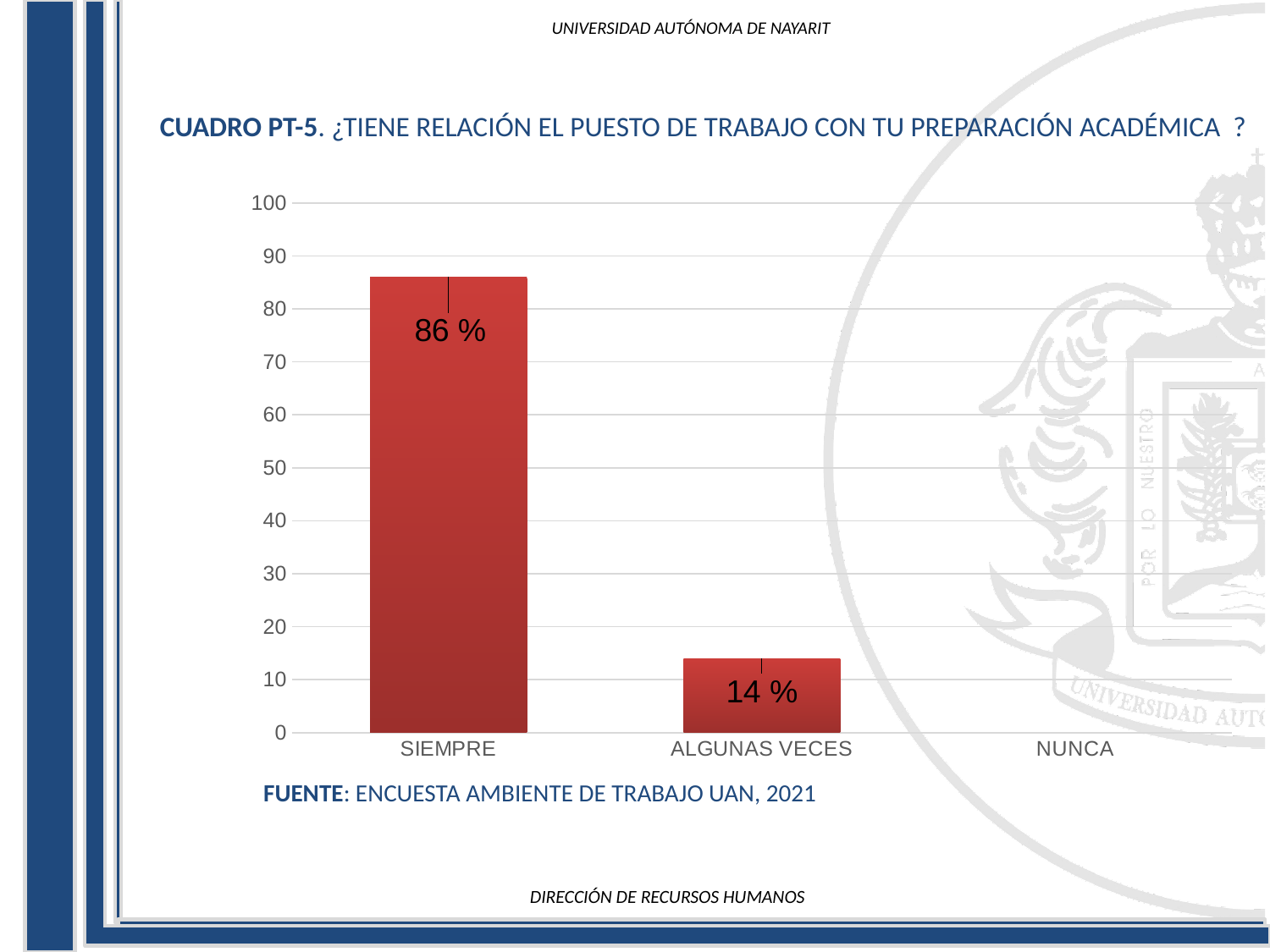
What is the source cited below the chart? ENCUESTA AMBIENTE DE TRABAJO UAN, 2021 Is the value for ALGUNAS VECES greater or less than 20? less How many categories are shown on the x axis? 3 Which is larger, the value for SIEMPRE or the value for ALGUNAS VECES? SIEMPRE What is the value for SIEMPRE? 86 % Which category has the highest value? SIEMPRE Is the value for SIEMPRE greater or less than 80? greater What is the difference between the values for SIEMPRE and ALGUNAS VECES? 72 % What kind of chart is shown on the slide? bar chart What is the value for ALGUNAS VECES? 14 % Do the values rise or fall from left to right along the x axis? fall